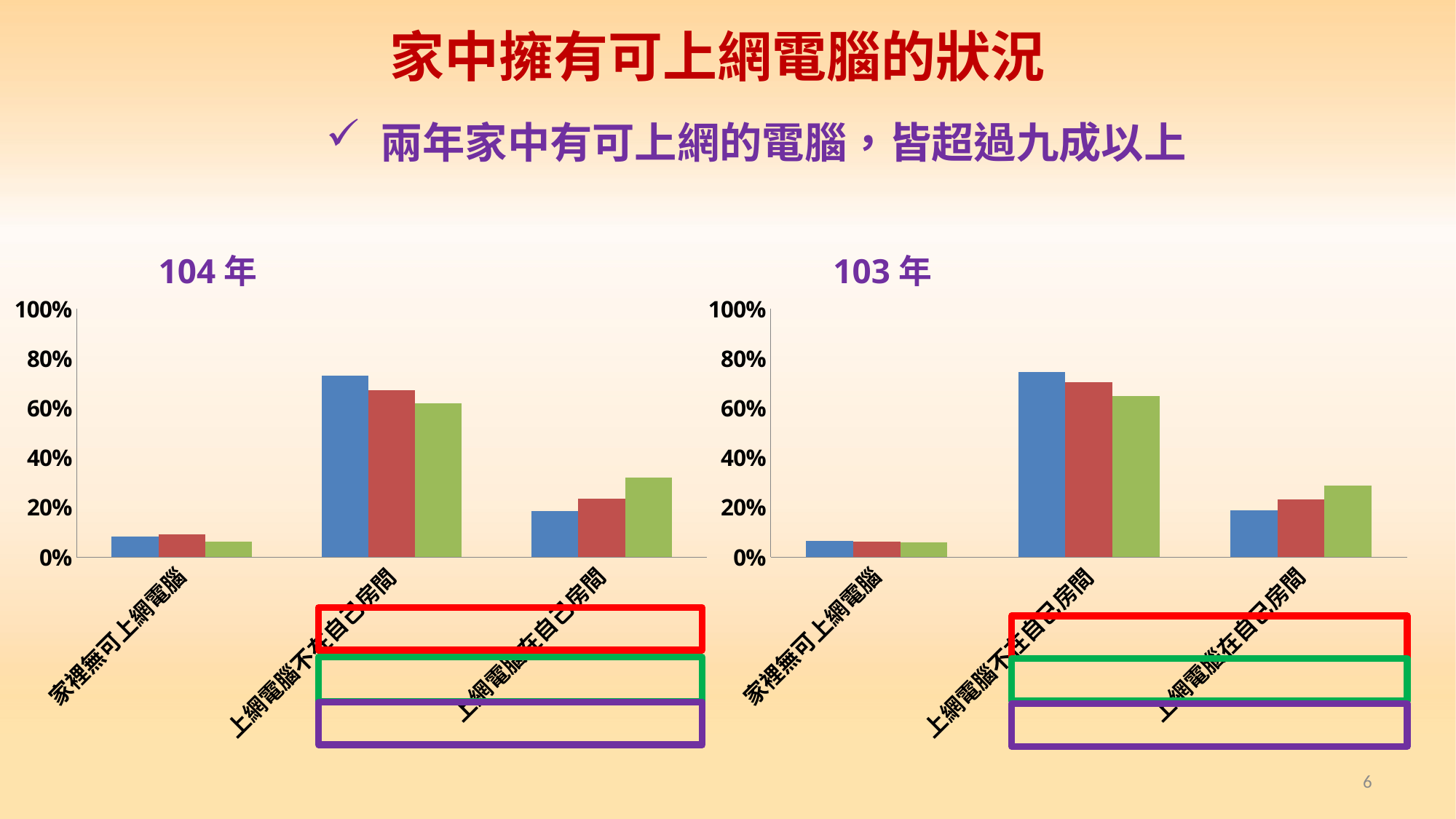
What kind of chart is the 104 年 chart? bar chart In the 104 年 chart, how many bars are plotted for each category? 3 In the 103 年 chart, which category has the shortest bars? 家裡無可上網電腦 What is the title of the chart on the right side of the slide? 103 年 In the 104 年 chart, for 上網電腦在自己房間, which bar is taller: the blue bar or the green bar? the green bar In the 103 年 chart, is the value of the blue bar for 家裡無可上網電腦 greater or less than 20%? less In the 104 年 chart, is the value of the green bar for 上網電腦在自己房間 greater or less than 20%? greater In the 103 年 chart, is the value of the green bar for 上網電腦不在自己房間 greater or less than 40%? greater In the 103 年 chart, for 上網電腦不在自己房間, which bar is taller: the blue bar or the green bar? the blue bar In the 104 年 chart, which category has the tallest bars? 上網電腦不在自己房間 How many categories are shown on the x axis of the 103 年 chart? 3